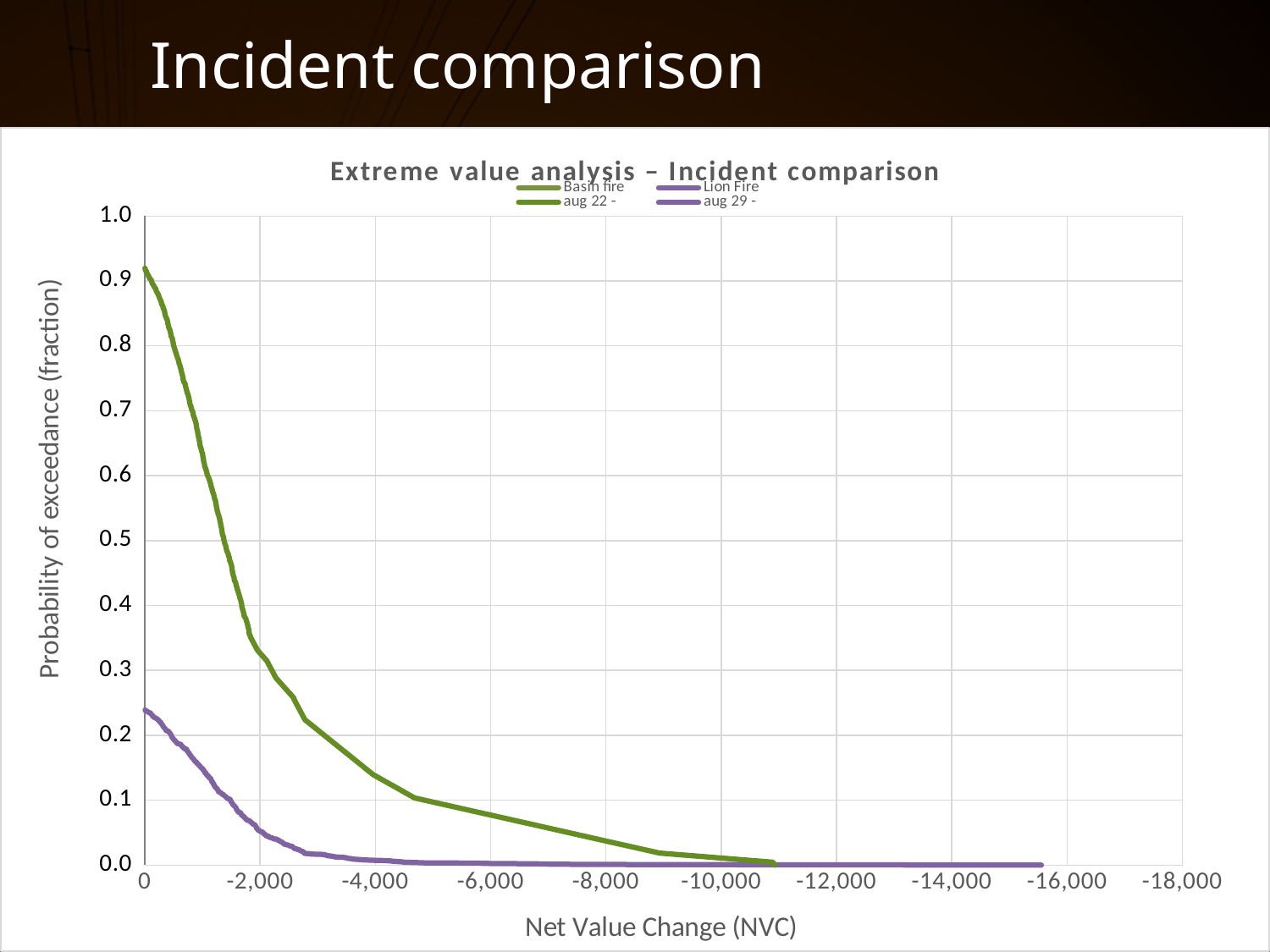
What is the label of the y axis? Probability of exceedance (fraction) What kind of chart is shown on the slide? line chart Is the probability of exceedance for the Lion Fire series at a Net Value Change of -2,000 greater or less than 0.1? less Do the values of the Lion Fire series rise or fall as the Net Value Change moves from 0 toward -16,000? fall Do the values of the Basin fire series rise or fall as the Net Value Change moves from 0 toward -10,000? fall Is the probability of exceedance for the Basin fire series at a Net Value Change of 0 greater or less than 0.8? greater How many series does the legend list? 4 What is the title of the chart? Extreme value analysis – Incident comparison At a Net Value Change of 0, which series has the higher probability of exceedance, Basin fire or Lion Fire? Basin fire Which series extends further along the x axis toward -16,000, Basin fire or Lion Fire? Lion Fire Is the probability of exceedance for the Lion Fire series at a Net Value Change of 0 greater or less than 0.3? less